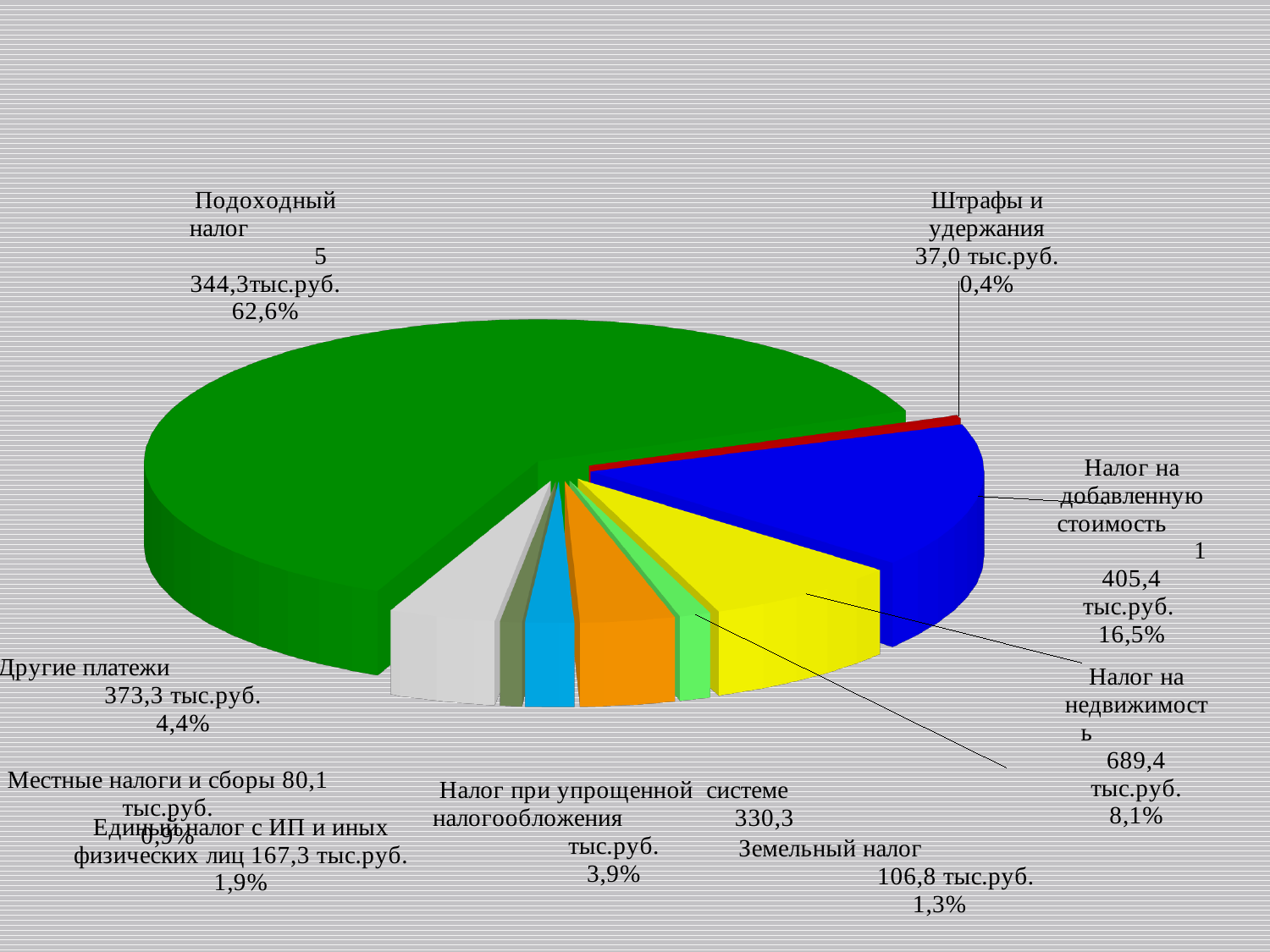
What is the value shown for Земельный налог? 106,8 тыс.руб. What is the value shown for Налог на добавленную стоимость? 1 405,4 тыс.руб. How many slices does the pie chart have? 9 Which is larger: Другие платежи or Налог при упрощенной системе налогообложения? Другие платежи What is the value shown for Штрафы и удержания? 37,0 тыс.руб. What percentage share is shown for Налог на недвижимость? 8,1% Which category has the largest share of the pie? Подоходный налог Which category has the smallest share of the pie? Штрафы и удержания What percentage share is shown for Единый налог с ИП и иных физических лиц? 1,9% What kind of chart is shown on the slide? pie chart What is the difference in percentage share between Налог на добавленную стоимость and Налог на недвижимость? 8,4% What share of the pie does Подоходный налог account for? 62,6%